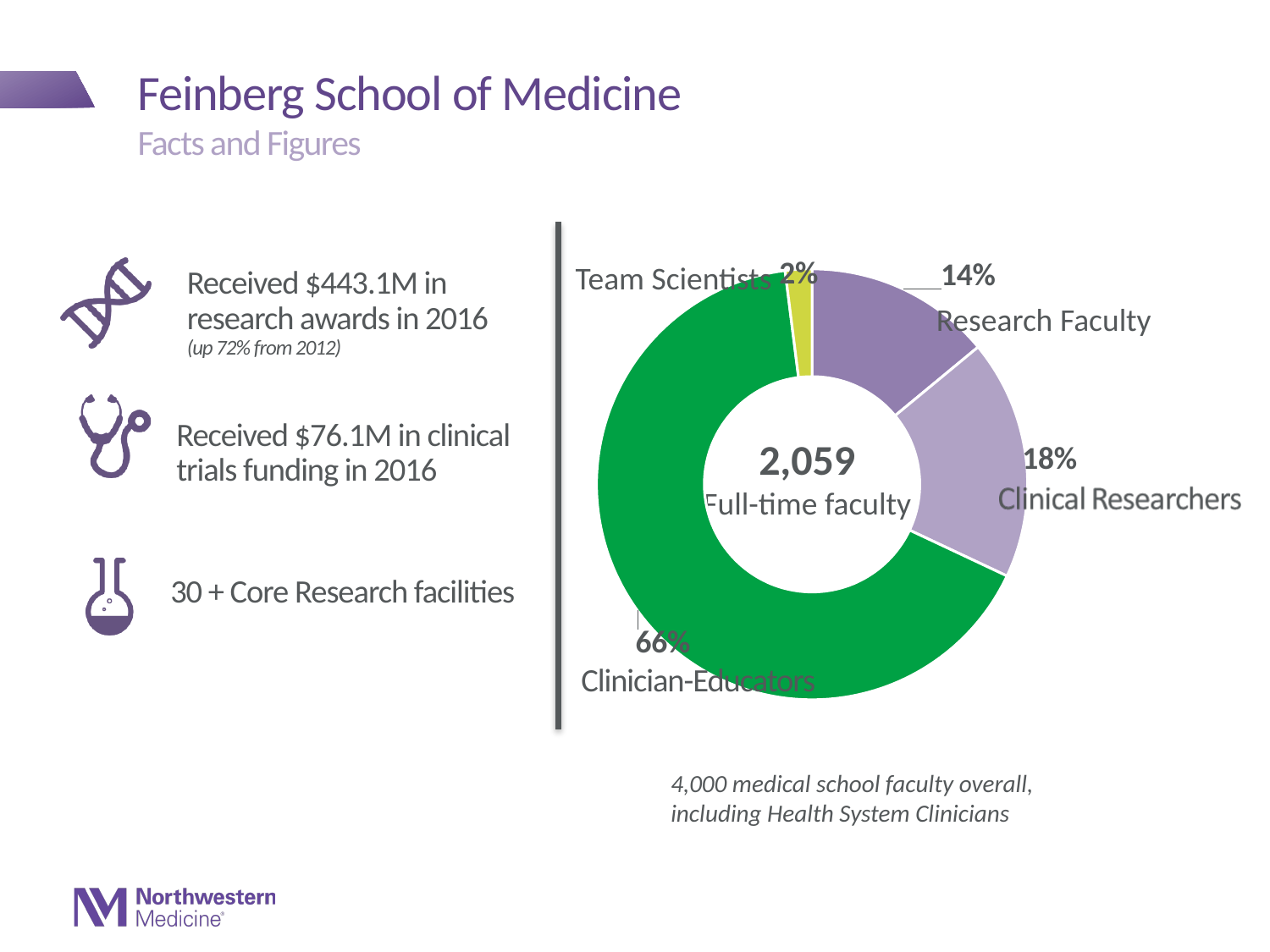
Which is larger, the share for Clinical Researchers or the share for Research Faculty? Clinical Researchers What number is shown in the center of the donut chart? 2,059 What does the number in the center of the donut chart represent? Full-time faculty What share of full-time faculty are Team Scientists? 2% Which category has the largest share of the chart? Clinician-Educators What kind of chart is shown on the slide? Pie chart (donut) What share of full-time faculty are Clinician-Educators? 66% What is the difference in percentage points between Clinical Researchers and Research Faculty? 4 percentage points Which category has the smallest share of the chart? Team Scientists What share of full-time faculty are Research Faculty? 14% How many categories does the chart show? 4 What share of full-time faculty are Clinical Researchers? 18%